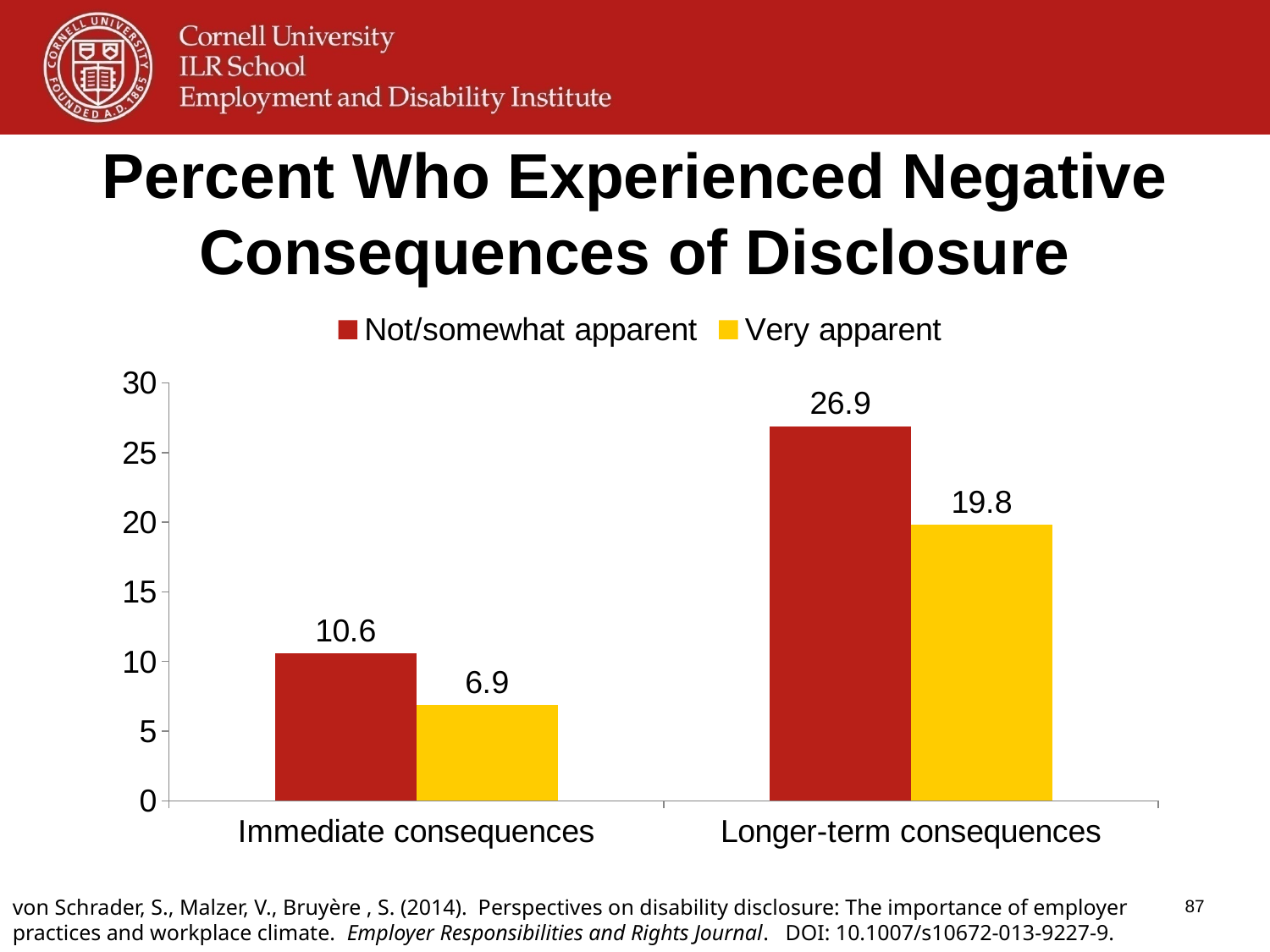
How many series does the legend list? 2 Which is larger for Immediate consequences: Not/somewhat apparent or Very apparent? Not/somewhat apparent What is the value for Very apparent under Immediate consequences? 6.9 How many categories are shown on the x axis? 2 What is the value for Not/somewhat apparent under Longer-term consequences? 26.9 What is the value for Very apparent under Longer-term consequences? 19.8 Is the value for Very apparent under Longer-term consequences greater or less than 15? greater What kind of chart is shown on the slide? Bar chart Which bar has the highest value on the chart? Not/somewhat apparent, Longer-term consequences Which bar has the lowest value on the chart? Very apparent, Immediate consequences What is the difference between the Not/somewhat apparent and Very apparent values for Longer-term consequences? 7.1 What is the value for Not/somewhat apparent under Immediate consequences? 10.6